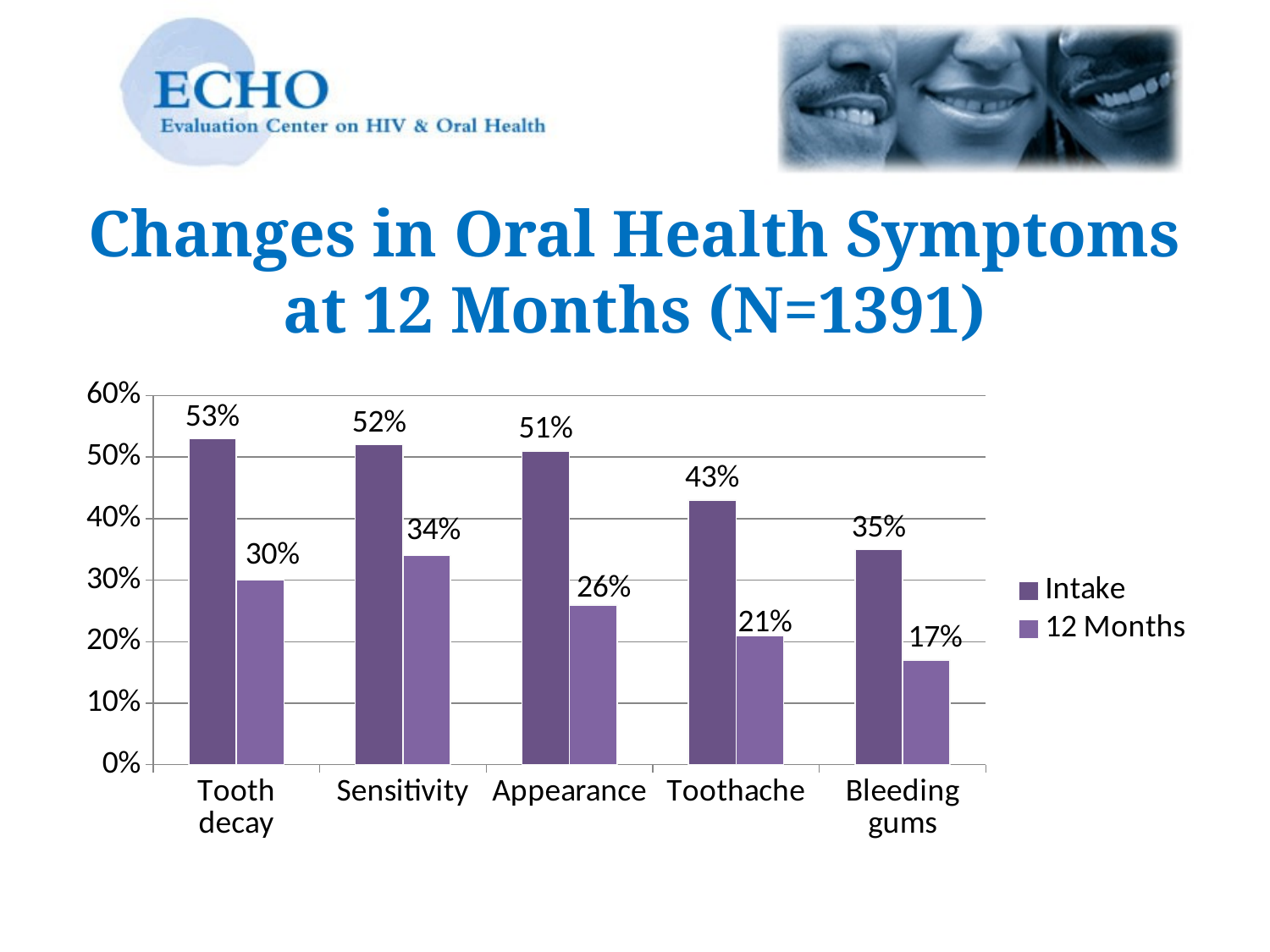
What is the Intake value for Tooth decay? 53% Which category has the highest Intake value? Tooth decay What is the difference between the Intake values for Tooth decay and Bleeding gums? 18% What are the two series named in the legend? Intake and 12 Months What kind of chart is shown on the slide? Bar chart What is the 12 Months value for Appearance? 26% What is the difference between the Intake and 12 Months values for Toothache? 22% How many series does the legend list? 2 How many symptom categories are shown on the x axis? 5 Which category has the lowest 12 Months value? Bleeding gums Which is larger: the 12 Months value for Sensitivity or the 12 Months value for Tooth decay? Sensitivity What is the 12 Months value for Bleeding gums? 17%